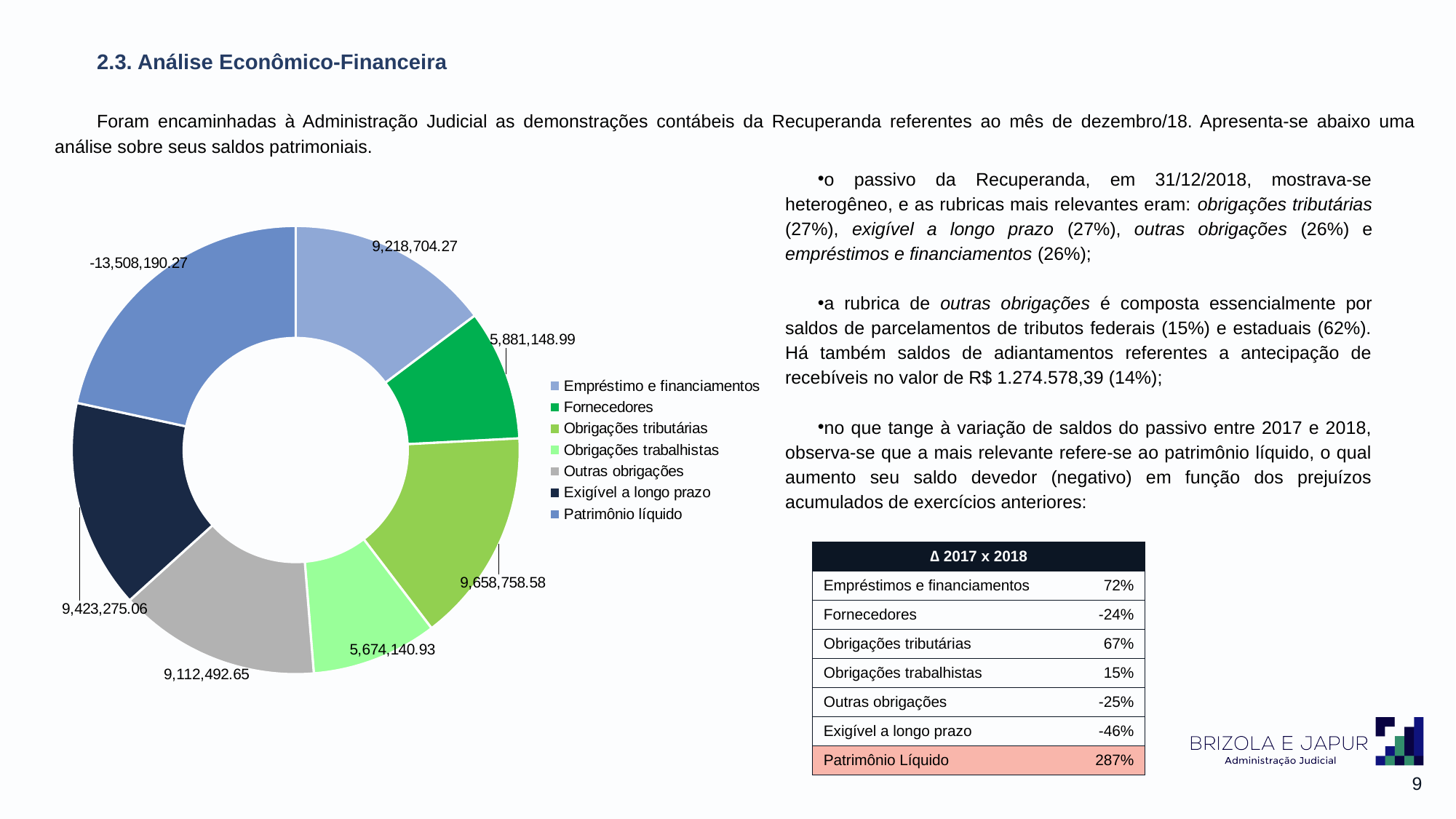
What is the value shown for Obrigações tributárias in the doughnut chart? 9,658,758.58 What is the difference between the values for Obrigações tributárias and Empréstimo e financiamentos in the doughnut chart? 440,054.31 In the doughnut chart, which is larger: the value for Exigível a longo prazo or the value for Outras obrigações? Exigível a longo prazo What is the value shown for Patrimônio líquido in the doughnut chart? -13,508,190.27 What is the value shown for Fornecedores in the doughnut chart? 5,881,148.99 Which category in the doughnut chart has the highest value? Obrigações tributárias What is the value shown for Exigível a longo prazo in the doughnut chart? 9,423,275.06 Which category in the doughnut chart has the lowest value? Patrimônio líquido What kind of chart is shown on the slide? Doughnut (pie) chart How many categories are shown in the doughnut chart? 7 What colour is used for Fornecedores in the doughnut chart legend? Green What is the difference between the values for Fornecedores and Obrigações trabalhistas in the doughnut chart? 207,008.06